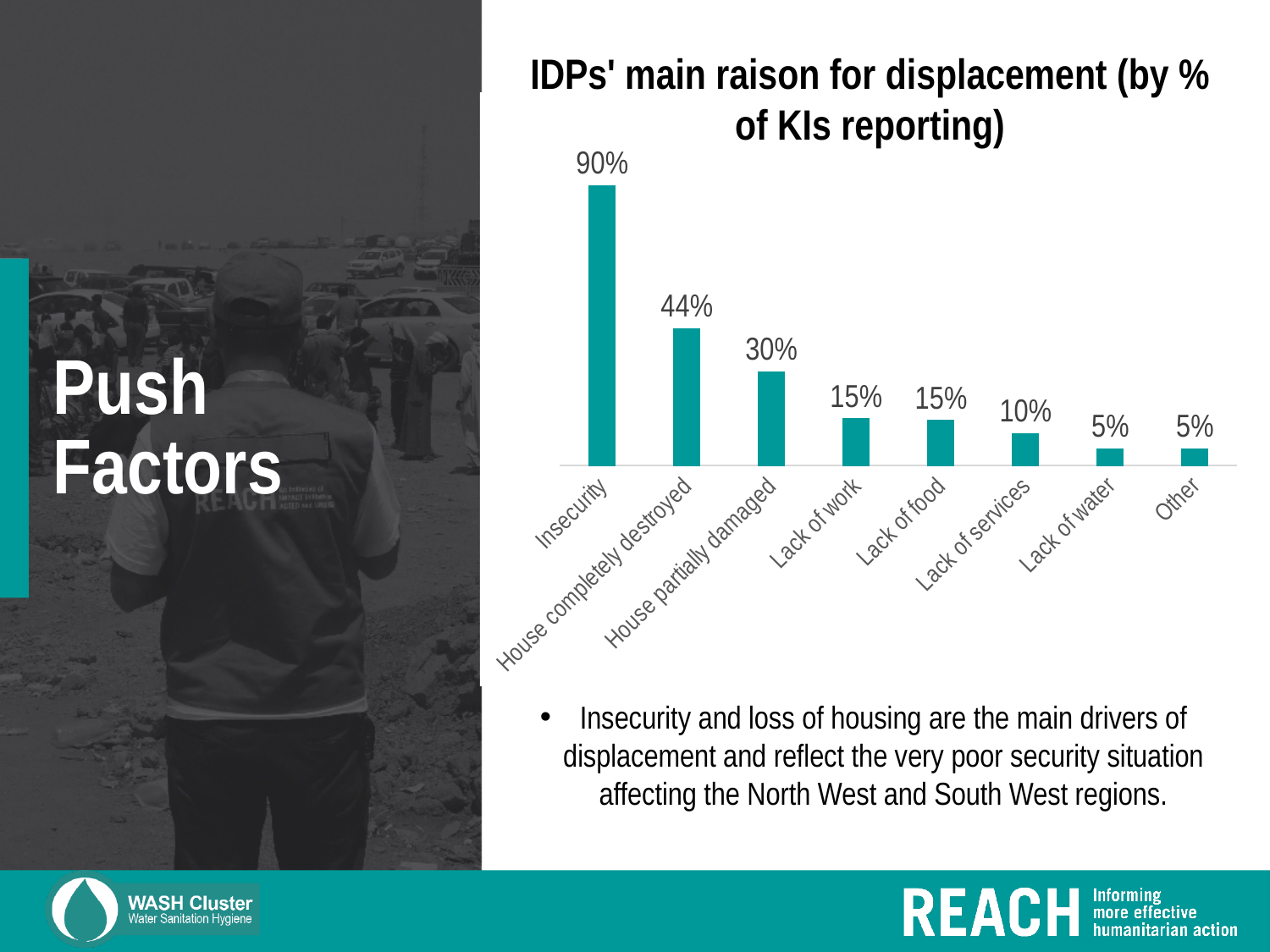
What is the value for House completely destroyed? 44% Which category has the highest value? Insecurity What value is shown for Lack of water? 5% What percentage of KIs reported Insecurity as the main reason for displacement? 90% What is the title of the chart? IDPs' main raison for displacement (by % of KIs reporting) What is the difference between House partially damaged and Lack of work? 15% Do the values generally rise or fall from left to right along the x axis? Fall What is the value for Lack of services? 10% What kind of chart is shown on the slide? Bar chart What is the difference between the values for Insecurity and House completely destroyed? 46% How many categories are shown on the chart? 8 Which is larger, the value for House partially damaged or the value for Lack of food? House partially damaged